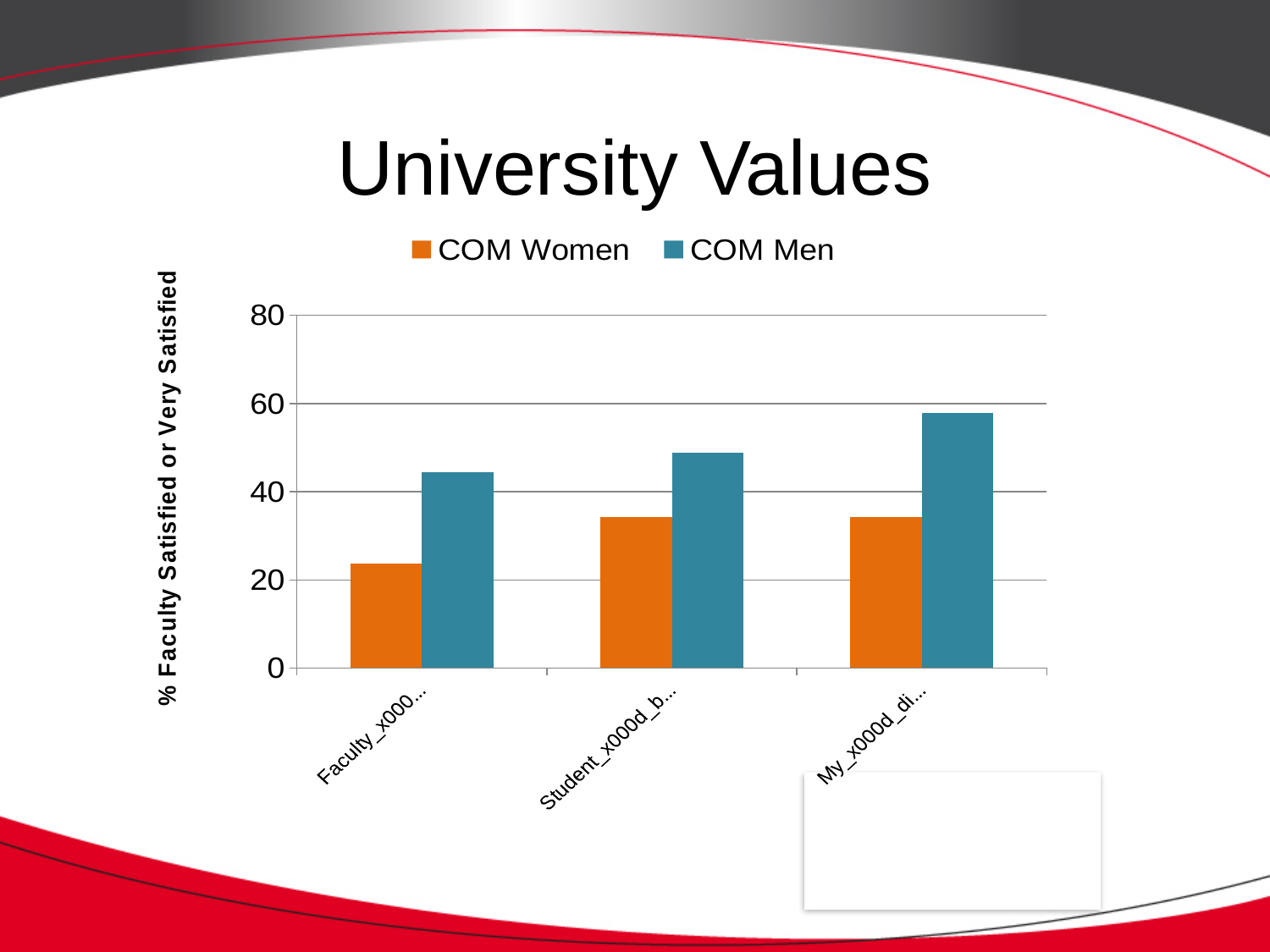
In which category is the COM Women value lowest? the first category (Faculty...) Is the COM Women value for the first category (Faculty...) greater or less than 40? less In the first category (Faculty...), which is larger, COM Women or COM Men? COM Men How many categories are plotted along the x axis? 3 Is the COM Men value for the third category (My...) greater or less than 40? greater Do the COM Men values rise or fall from the first category to the third? rise What is the label of the vertical axis? % Faculty Satisfied or Very Satisfied How many series does the legend list? 2 What kind of chart is shown on the slide? bar chart Which series is shown in orange? COM Women In the third category (My...), which is larger, COM Women or COM Men? COM Men In which category is the COM Men value highest? the third category (My...)